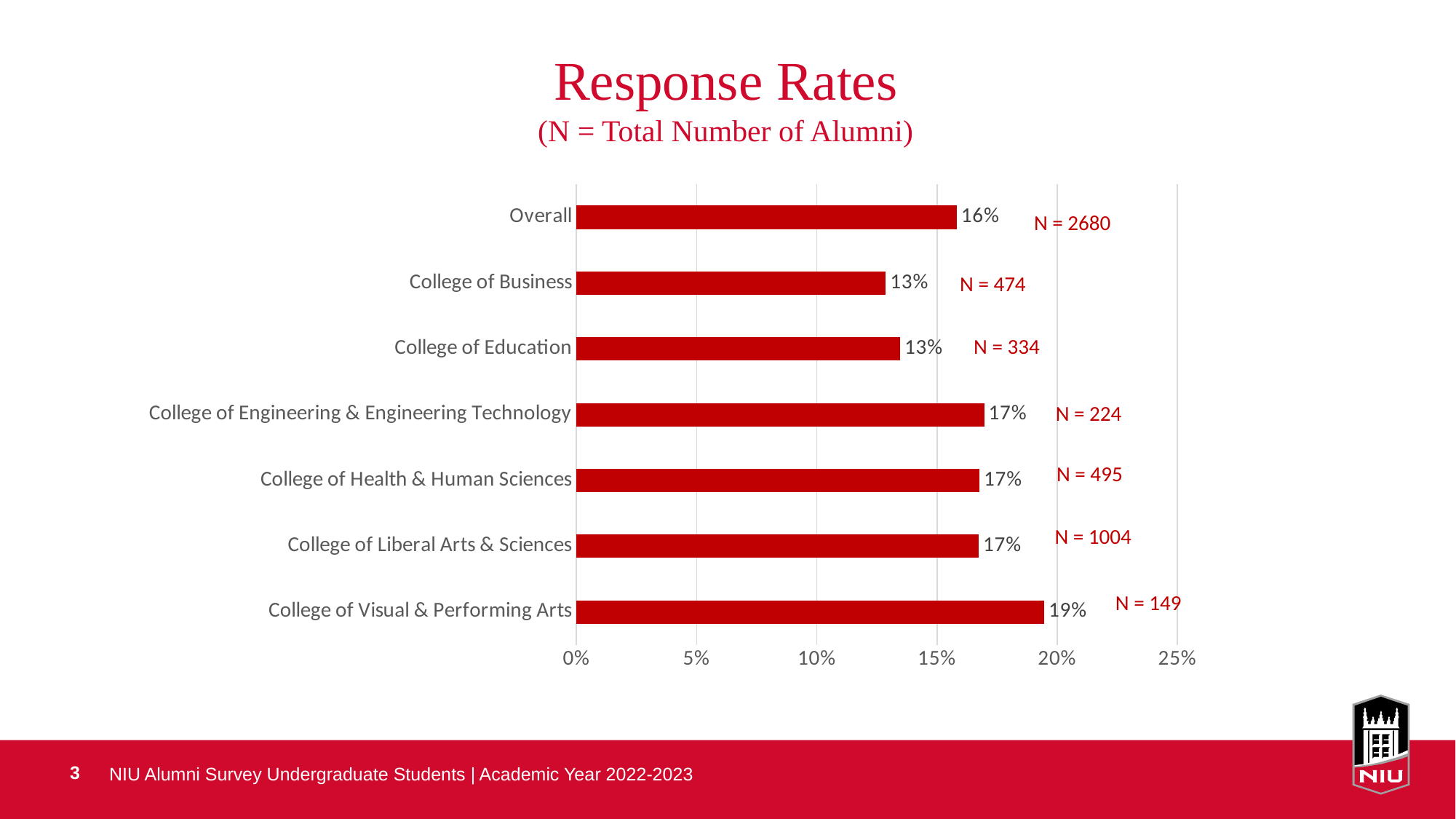
What is the difference between the response rate for the College of Visual & Performing Arts and the Overall response rate? 3 percentage points What is the N value shown for Overall? N = 2680 What is the response rate for the College of Engineering & Engineering Technology? 17% Which has a higher response rate, the College of Visual & Performing Arts or the College of Business? College of Visual & Performing Arts How many categories are plotted in the chart? 7 Which category has the highest response rate? College of Visual & Performing Arts What is the N value shown for the College of Liberal Arts & Sciences? N = 1004 What is the response rate for Overall? 16% What is the response rate for the College of Visual & Performing Arts? 19% What is the response rate for the College of Business? 13% Is the Overall response rate greater or less than 15%? greater What type of chart is shown on the slide? bar chart